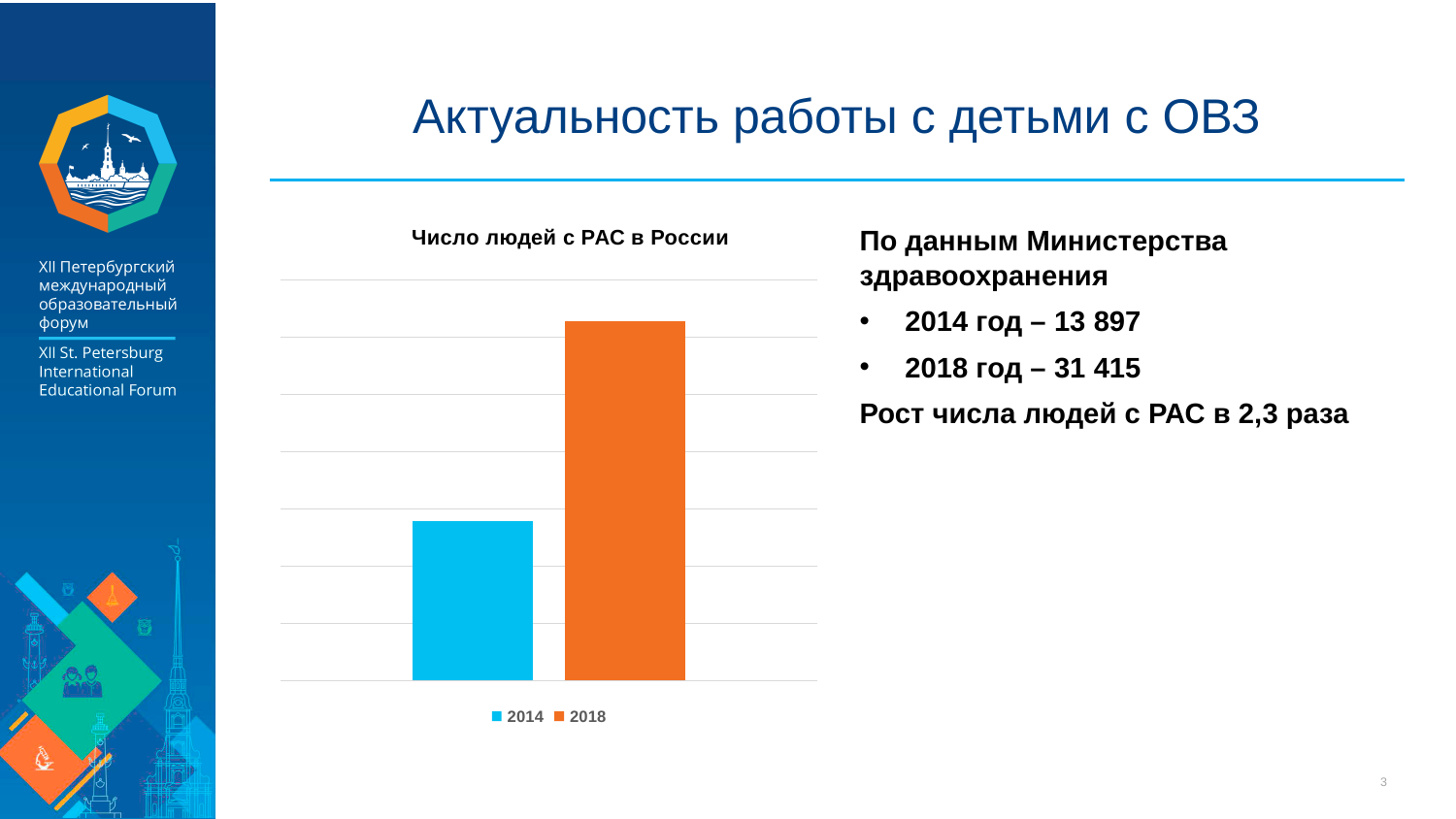
What kind of chart is shown on the slide? bar chart By how much did the number of people with РАС in Russia increase from 2014 to 2018, using the values printed on the slide? 17 518 Which year has the higher bar in the chart? 2018 Do the values rise or fall from 2014 to 2018? rise How many bars are plotted in the chart? 2 What is the title of the chart? Число людей с РАС в России Is the bar for 2018 larger or smaller than the bar for 2014? larger How many series does the chart legend list? 2 Which year has the lower bar in the chart? 2014 What colour is the bar for 2018 in the chart? orange According to the slide, what is the number of people with РАС in Russia in 2018? 31 415 According to the slide, what is the number of people with РАС in Russia in 2014? 13 897